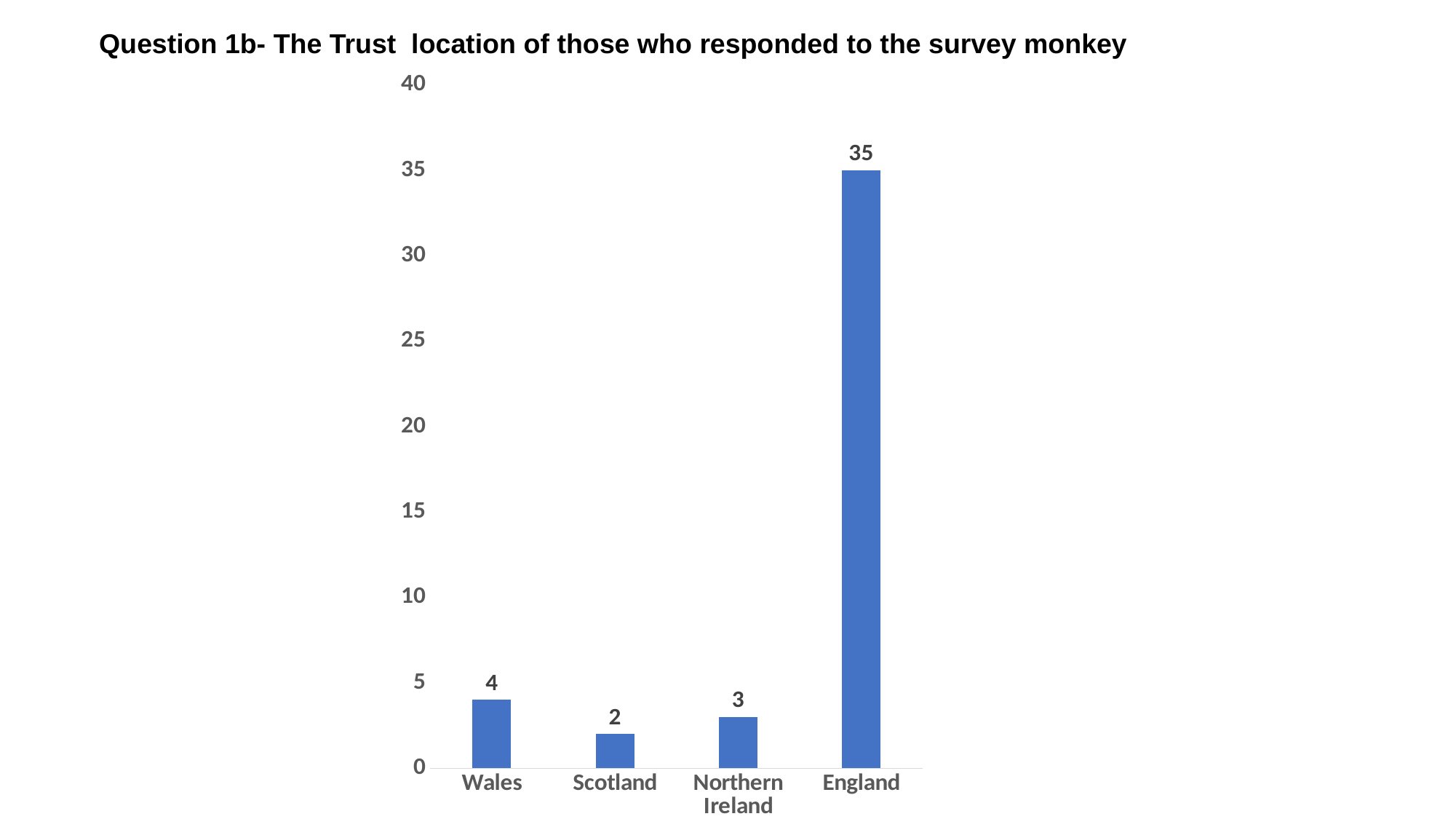
What is the difference between the values for England and Wales? 31 What is the value for England? 35 What is the value for Scotland? 2 Which location has the highest value? England What kind of chart is shown on the slide? bar chart Which location has the lowest value? Scotland What is the value for Northern Ireland? 3 Which is larger, the value for Wales or the value for Northern Ireland? Wales What is the value for Wales? 4 How many locations are shown on the chart? 4 Is the value for England greater or less than 30? greater What is the difference between the values for Wales and Scotland? 2